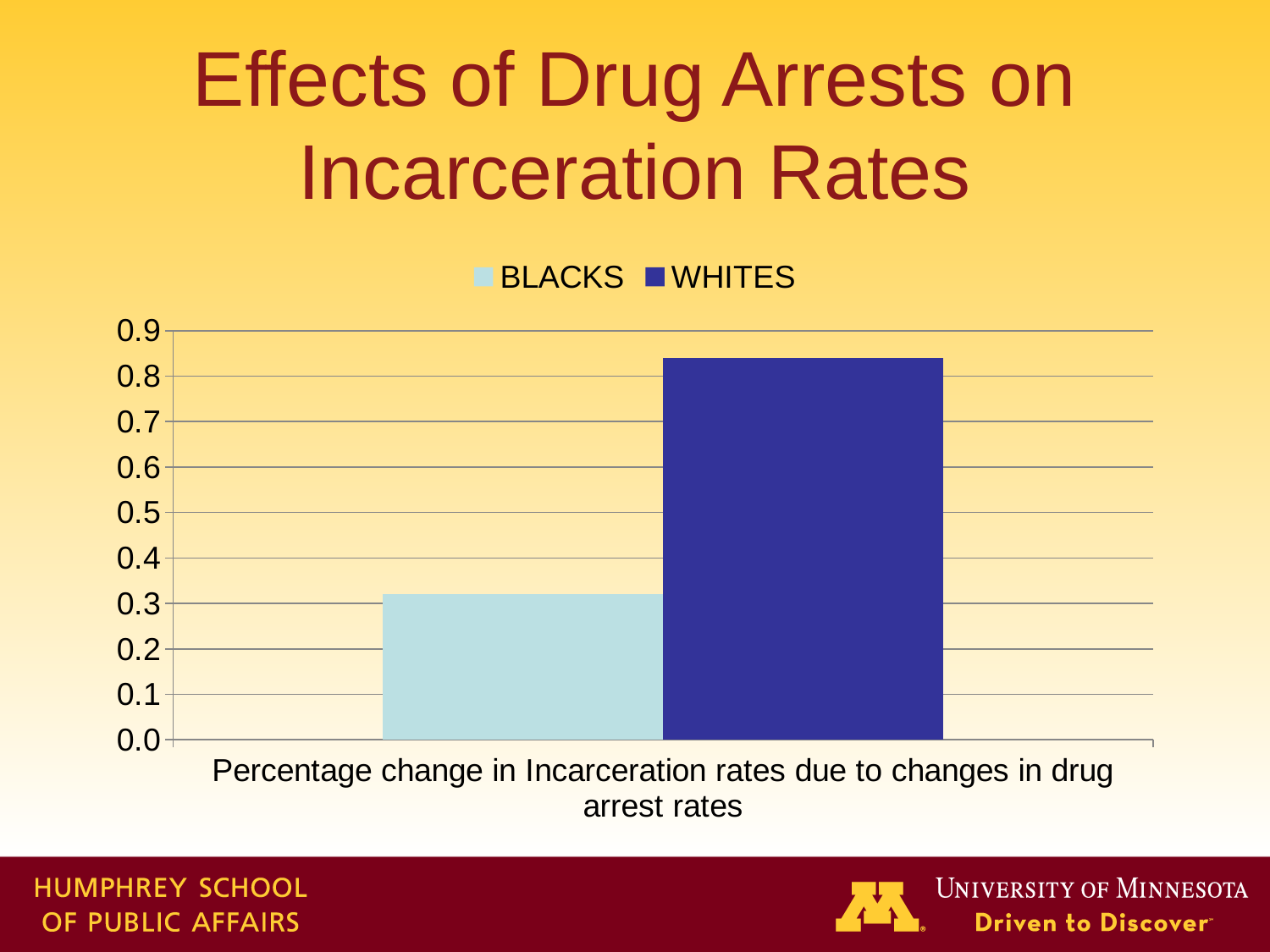
How many series does the legend list? 2 Which series has the highest bar? WHITES Which series has the lowest bar? BLACKS What kind of chart is shown on the slide? bar chart Is the value for WHITES greater or less than 0.8? greater How many bars are plotted on the chart? 2 What is the title of the slide containing the chart? Effects of Drug Arrests on Incarceration Rates Is the value for WHITES greater or less than 0.9? less Is the value for BLACKS greater or less than 0.4? less Which series has the higher bar, BLACKS or WHITES? WHITES What colour is the bar for WHITES? dark blue